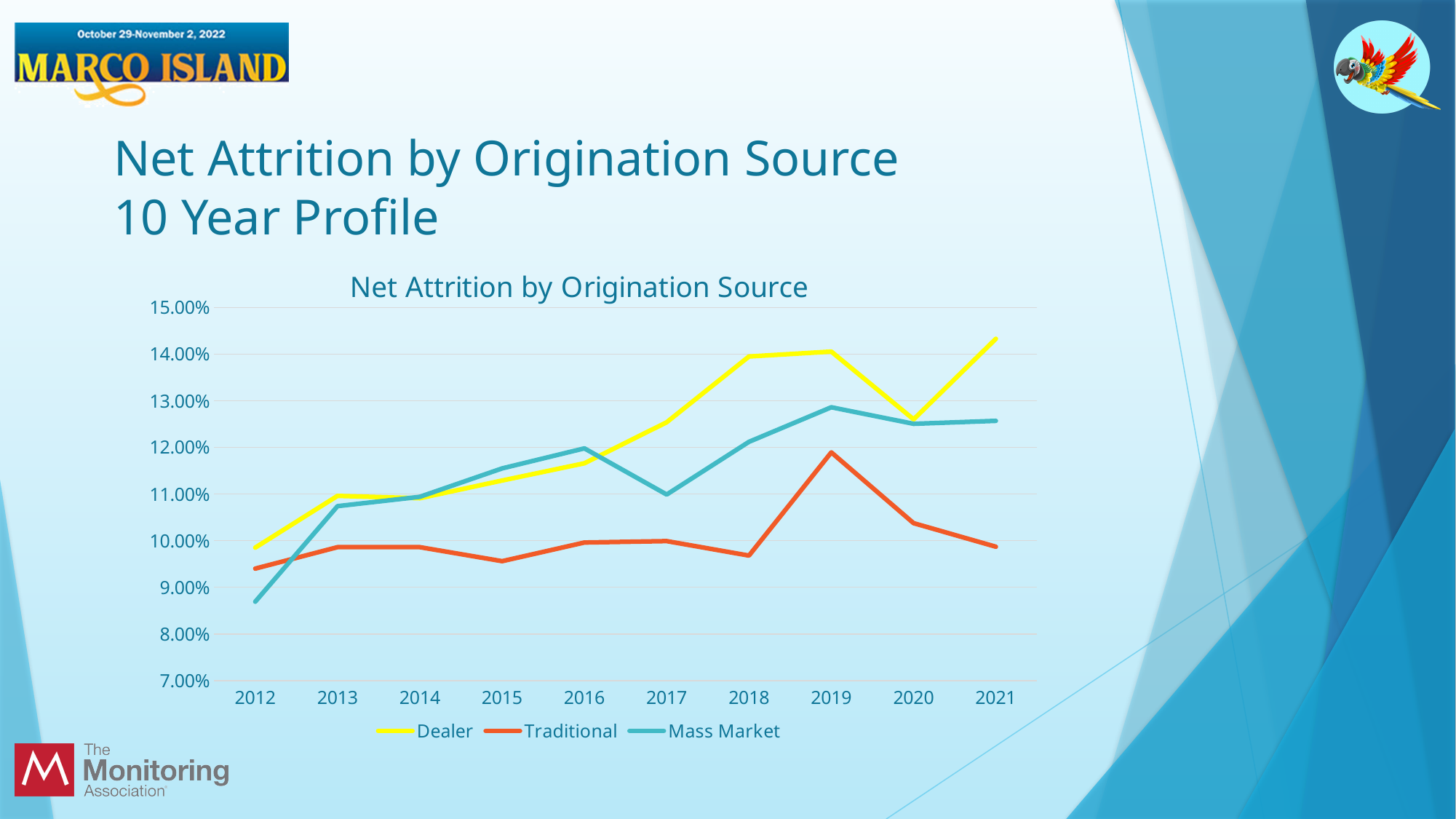
How many series does the legend of the Net Attrition by Origination Source chart list? 3 Does the Dealer series generally rise or fall from 2012 to 2019? rise Is the Mass Market value for 2019 greater or less than 12.00%? greater Is the Dealer value for 2021 greater or less than 14.00%? greater Is the Mass Market value for 2012 greater or less than 9.00%? less Which series has the lowest net attrition in 2012? Mass Market How many years are plotted along the x axis of the chart? 10 In 2017, which is larger: the Dealer value or the Mass Market value? Dealer Which series has the highest net attrition in 2021? Dealer What kind of chart is shown on the slide? line chart In which year does the Traditional series reach its highest value? 2019